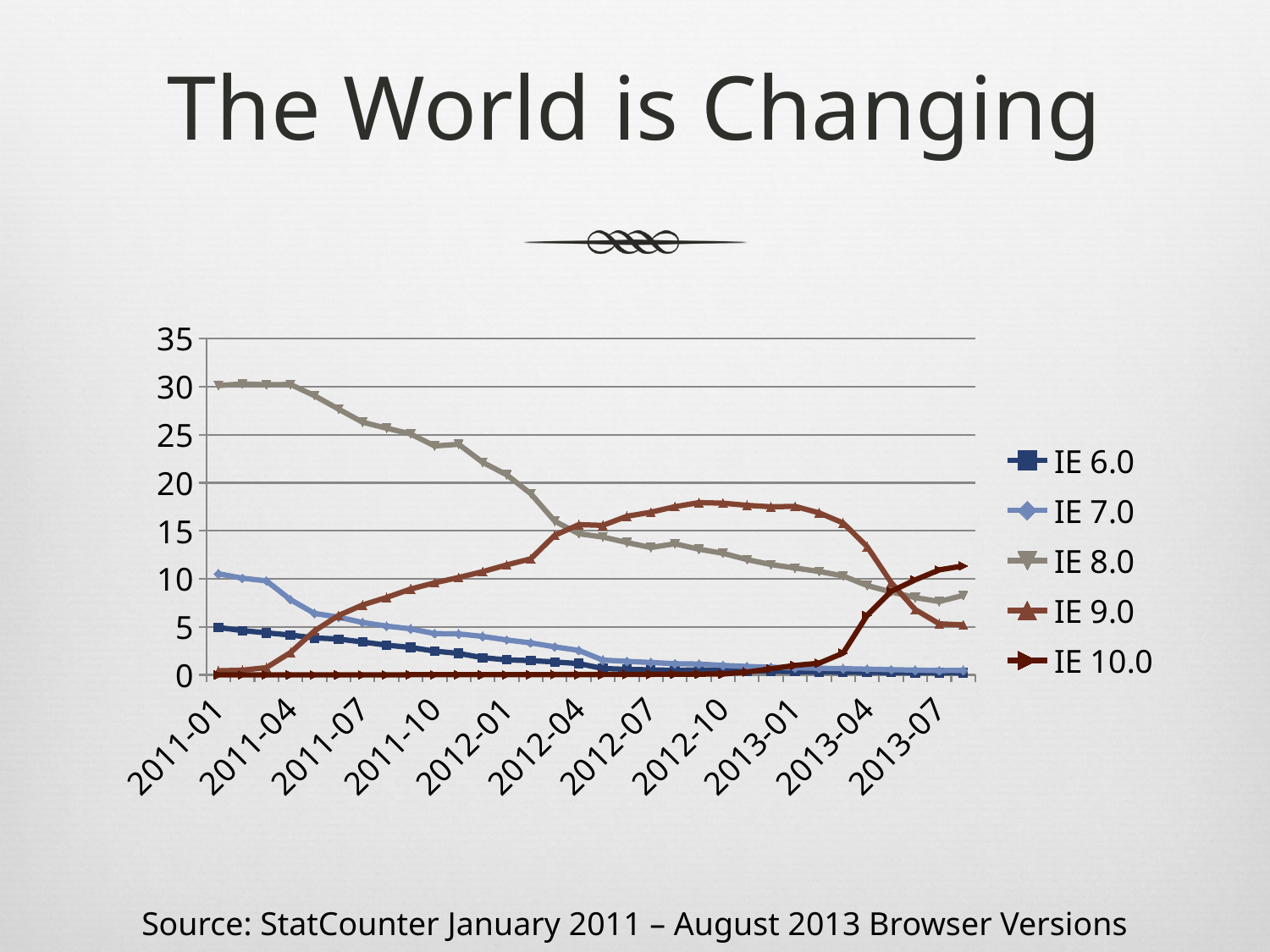
What is the highest value shown on the vertical axis? 35 Does the IE 6.0 line rise or fall across the x axis? fall Is the value for IE 9.0 at 2011-01 greater or less than 5? less Which series are listed in the legend? IE 6.0, IE 7.0, IE 8.0, IE 9.0, IE 10.0 Does the IE 10.0 line rise or fall from 2013-01 to 2013-07? rise Does the IE 8.0 line rise or fall from 2011-01 to 2013-07? fall Is the value for IE 9.0 at 2012-10 greater or less than 15? greater Is the value for IE 8.0 at 2011-01 greater or less than 25? greater How many series does the legend list? 5 Which series has the highest value at 2011-01? IE 8.0 What kind of chart is shown on the slide? line chart At 2012-10, which is larger: IE 9.0 or IE 8.0? IE 9.0